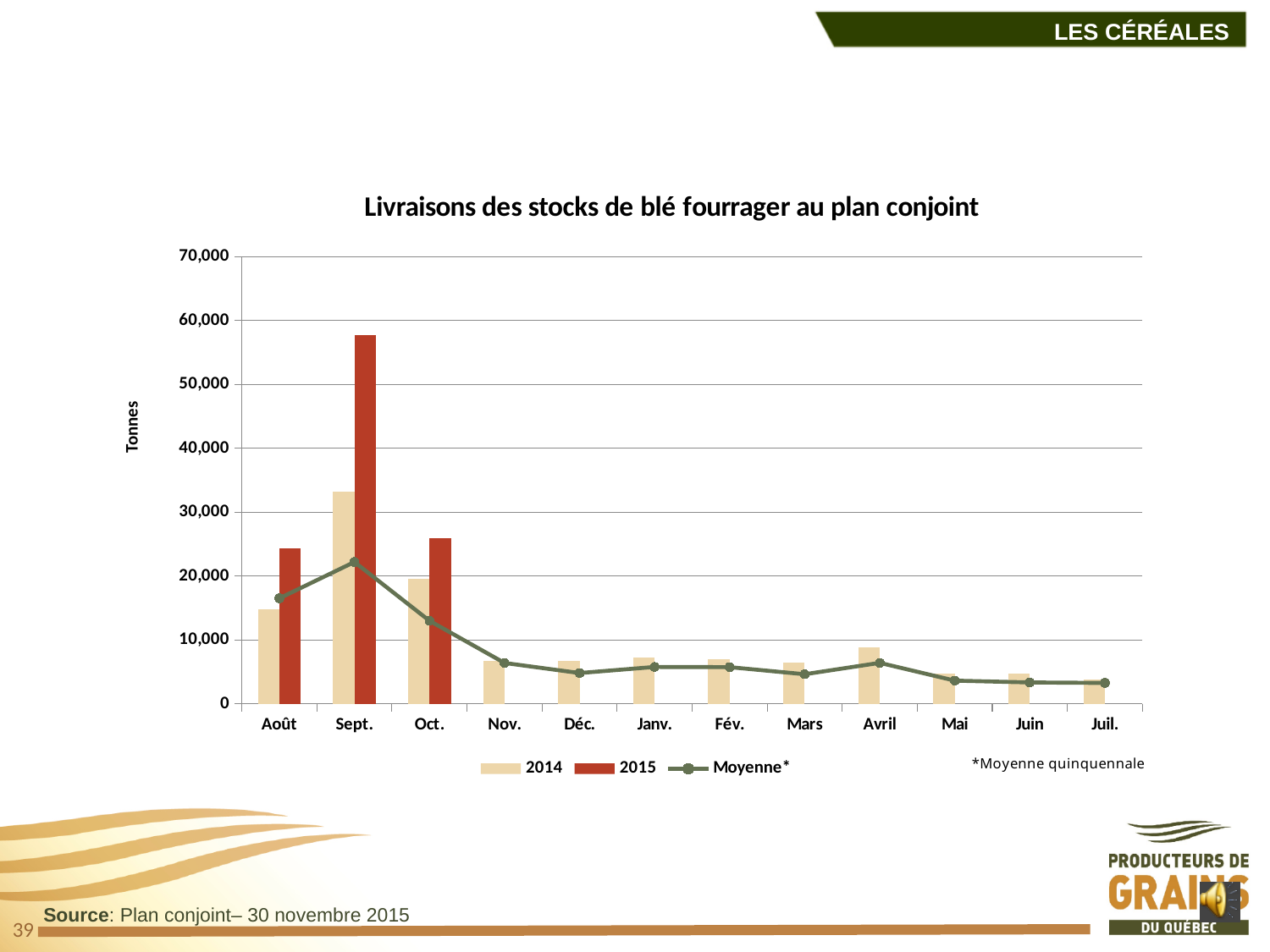
Is the 2015 value for Oct. greater or less than 20,000? greater What kind of chart is this? Bar chart with a line series Is the 2014 value for Août greater or less than 20,000? less What is the title of the chart? Livraisons des stocks de blé fourrager au plan conjoint How many series does the legend list? 3 How many months are shown on the x axis? 12 Which is larger for Sept., the 2014 bar or the 2015 bar? 2015 In which month is the 2014 bar highest? Sept. What unit is shown on the y axis label? Tonnes Is the 2015 value for Sept. greater or less than 50,000? greater Does the Moyenne* line rise or fall from Sept. to Nov.? fall In which month is the 2015 bar highest? Sept.